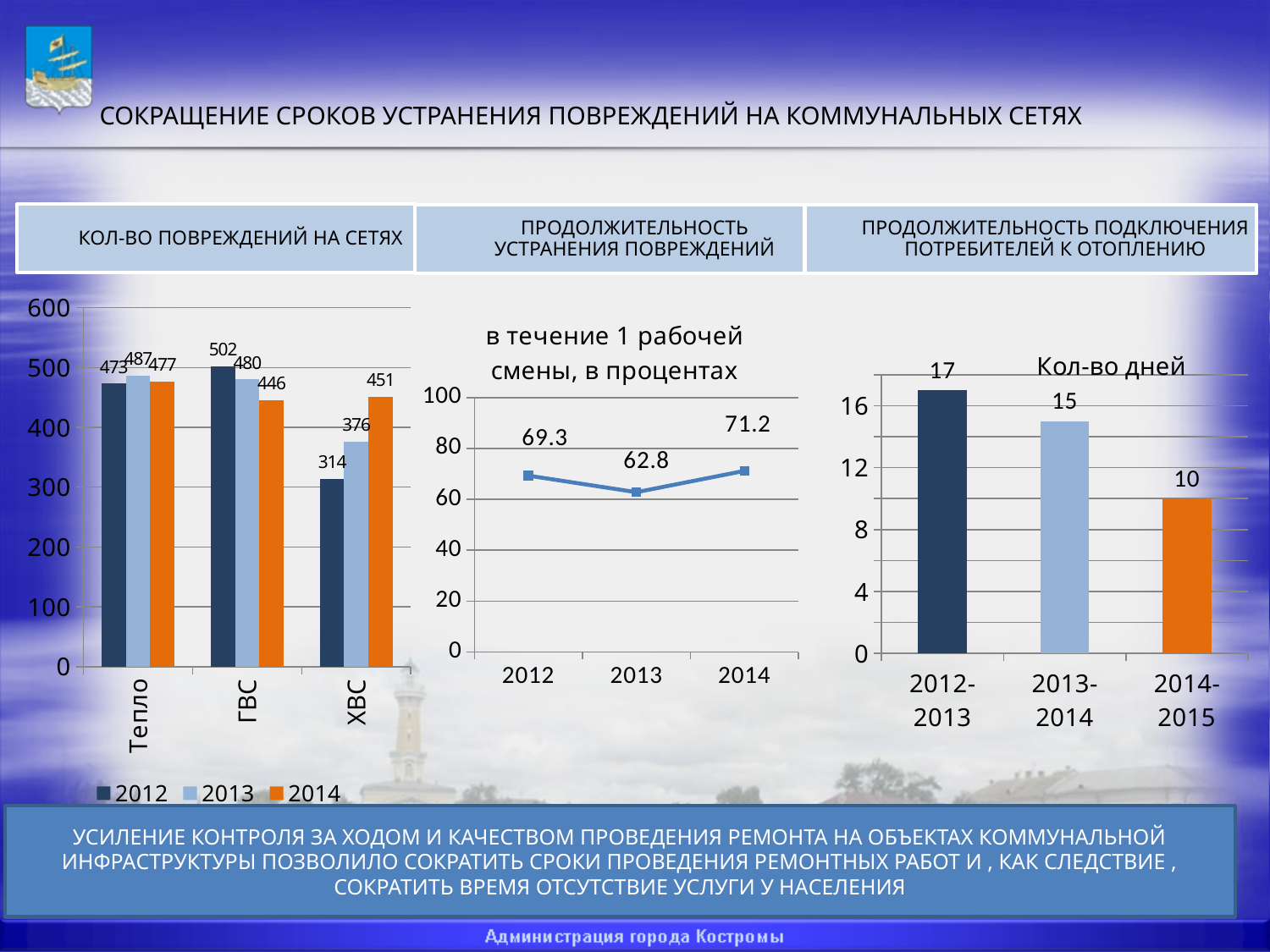
What kind of chart is the middle chart (в течение 1 рабочей смены, в процентах)? line chart In the left chart (КОЛ-ВО ПОВРЕЖДЕНИЙ НА СЕТЯХ), what is the difference between the 2014 and 2012 values for ХВС? 137 In the middle chart (в течение 1 рабочей смены, в процентах), which year has the highest value? 2014 In the left chart (КОЛ-ВО ПОВРЕЖДЕНИЙ НА СЕТЯХ), what is the value for ГВС in 2012? 502 In the right chart (Кол-во дней), what is the value for 2014-2015? 10 In the right chart (Кол-во дней), do the values rise or fall from 2012-2013 to 2014-2015? fall In the left chart (КОЛ-ВО ПОВРЕЖДЕНИЙ НА СЕТЯХ), how many series does the legend list? 3 In the left chart (КОЛ-ВО ПОВРЕЖДЕНИЙ НА СЕТЯХ), what is the value for ХВС in 2014? 451 In the left chart (КОЛ-ВО ПОВРЕЖДЕНИЙ НА СЕТЯХ), which category has the lowest value in 2012? ХВС In the middle chart (в течение 1 рабочей смены, в процентах), what is the value for 2013? 62.8 In the right chart (Кол-во дней), what is the difference between the 2012-2013 and 2014-2015 values? 7 In the left chart (КОЛ-ВО ПОВРЕЖДЕНИЙ НА СЕТЯХ), do the values for ХВС rise or fall from 2012 to 2014? rise